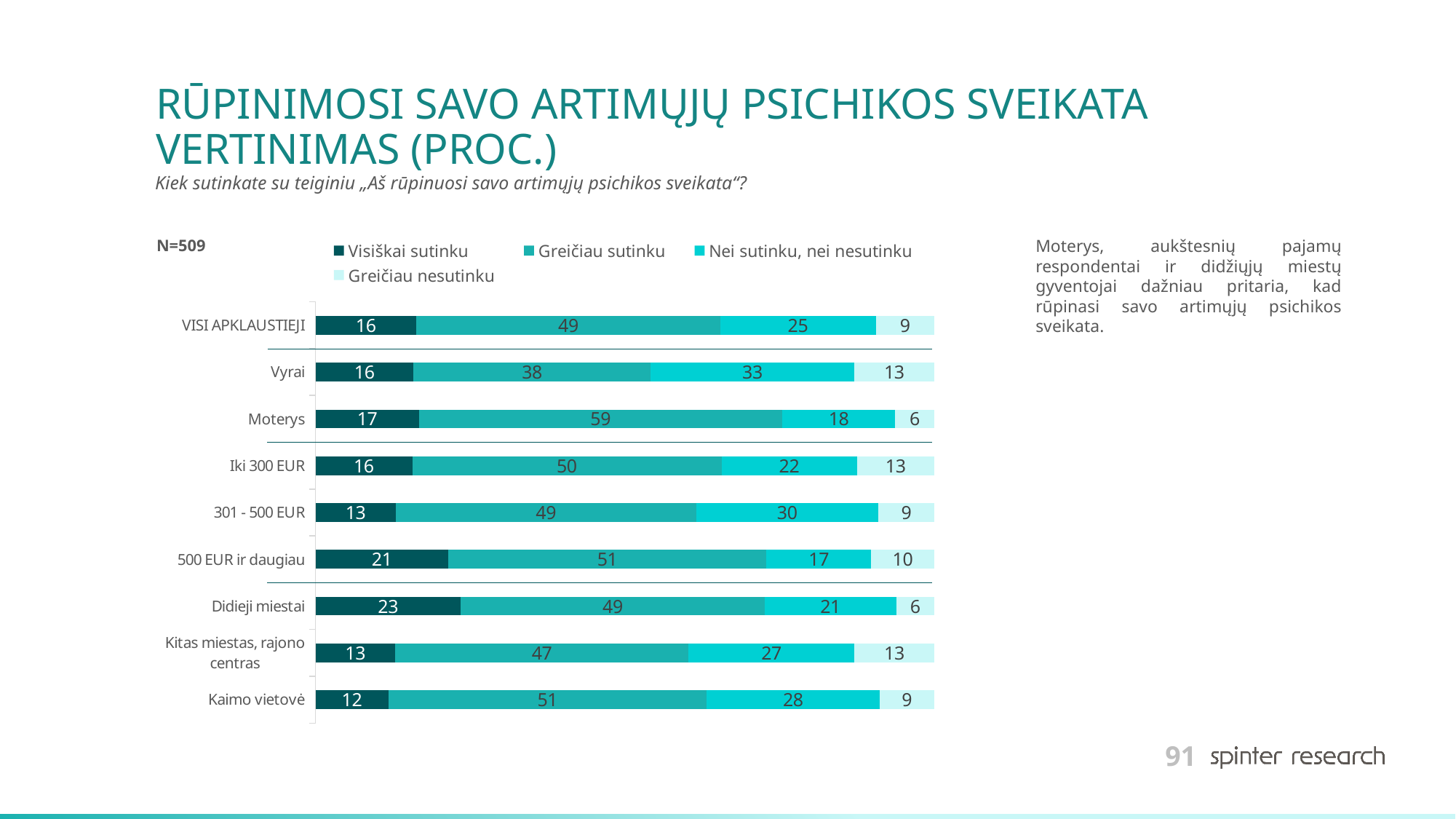
What is the total of the stacked bar for 500 EUR ir daugiau? 99 What is the value of "Greičiau sutinku" for Vyrai? 38 Which is larger: the "Nei sutinku, nei nesutinku" value for Vyrai or for Moterys? Vyrai What is the value of "Greičiau nesutinku" for Kaimo vietovė? 9 What is the difference between the "Greičiau sutinku" values for Moterys and Vyrai? 21 How many categories are shown on the chart? 9 What kind of chart is shown on the slide? Stacked bar chart What is the value of "Nei sutinku, nei nesutinku" for 301 - 500 EUR? 30 How many series does the legend list? 4 What is the value of "Visiškai sutinku" for Moterys? 17 Which category has the highest value for "Visiškai sutinku"? Didieji miestai Which category has the lowest value for "Greičiau sutinku"? Vyrai